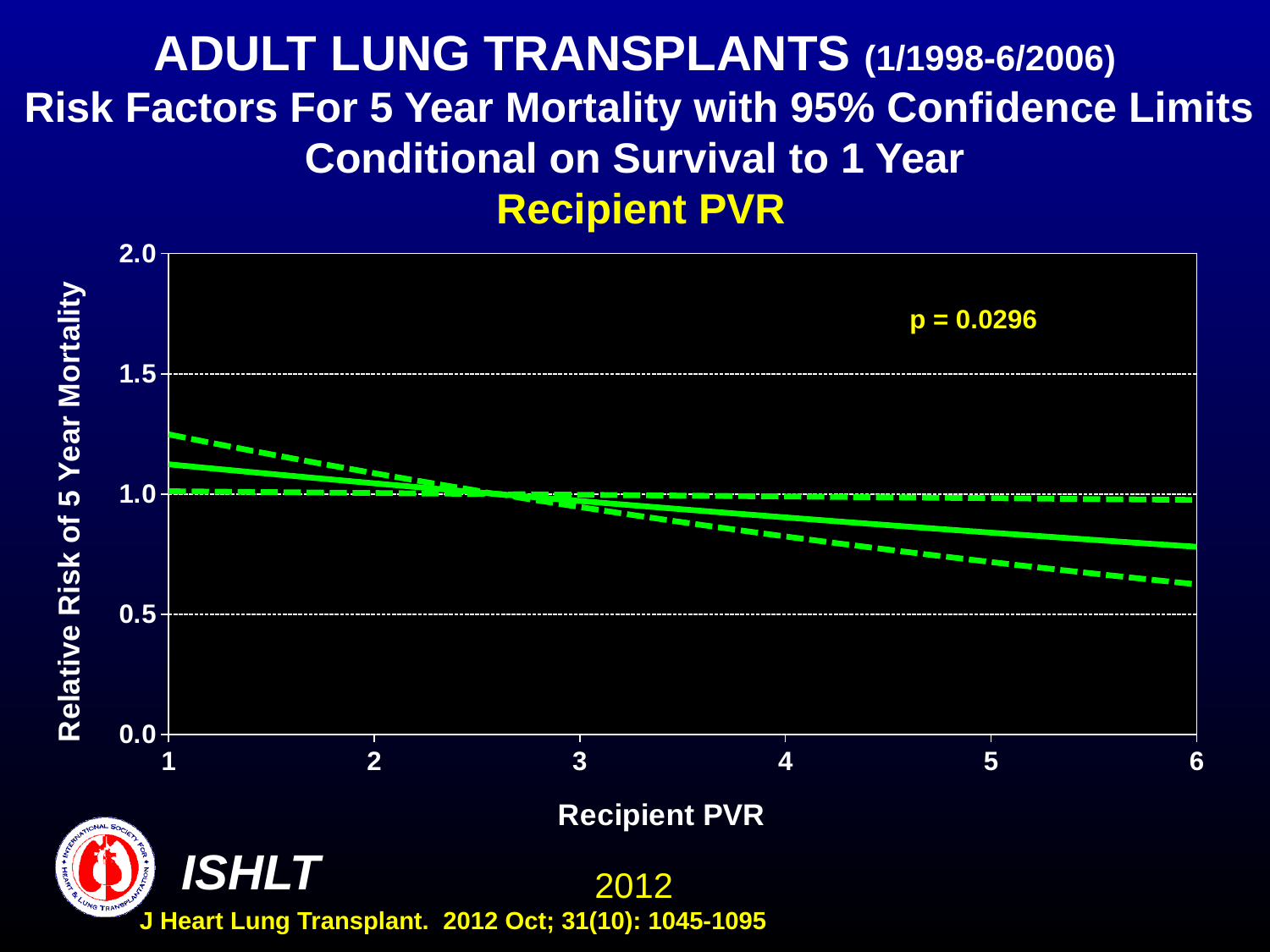
What kind of chart is shown on the slide? line chart Is the relative risk (solid line) at a Recipient PVR of 1 greater or less than 1.0? greater What is the label of the y axis? Relative Risk of 5 Year Mortality How many lines are plotted on the chart? 3 At which Recipient PVR value on the x axis is the relative risk (solid line) highest? 1 Is the lower 95% confidence limit (lower dashed line) at a Recipient PVR of 6 greater or less than 0.5? greater Does the relative risk of 5 year mortality rise or fall as Recipient PVR increases from 1 to 6? fall Is the upper 95% confidence limit (upper dashed line) at a Recipient PVR of 1 greater or less than 1.0? greater What p-value is printed on the chart? p = 0.0296 At which Recipient PVR value on the x axis is the relative risk (solid line) lowest? 6 Is the relative risk (solid line) larger at a Recipient PVR of 2 or at a Recipient PVR of 5? 2